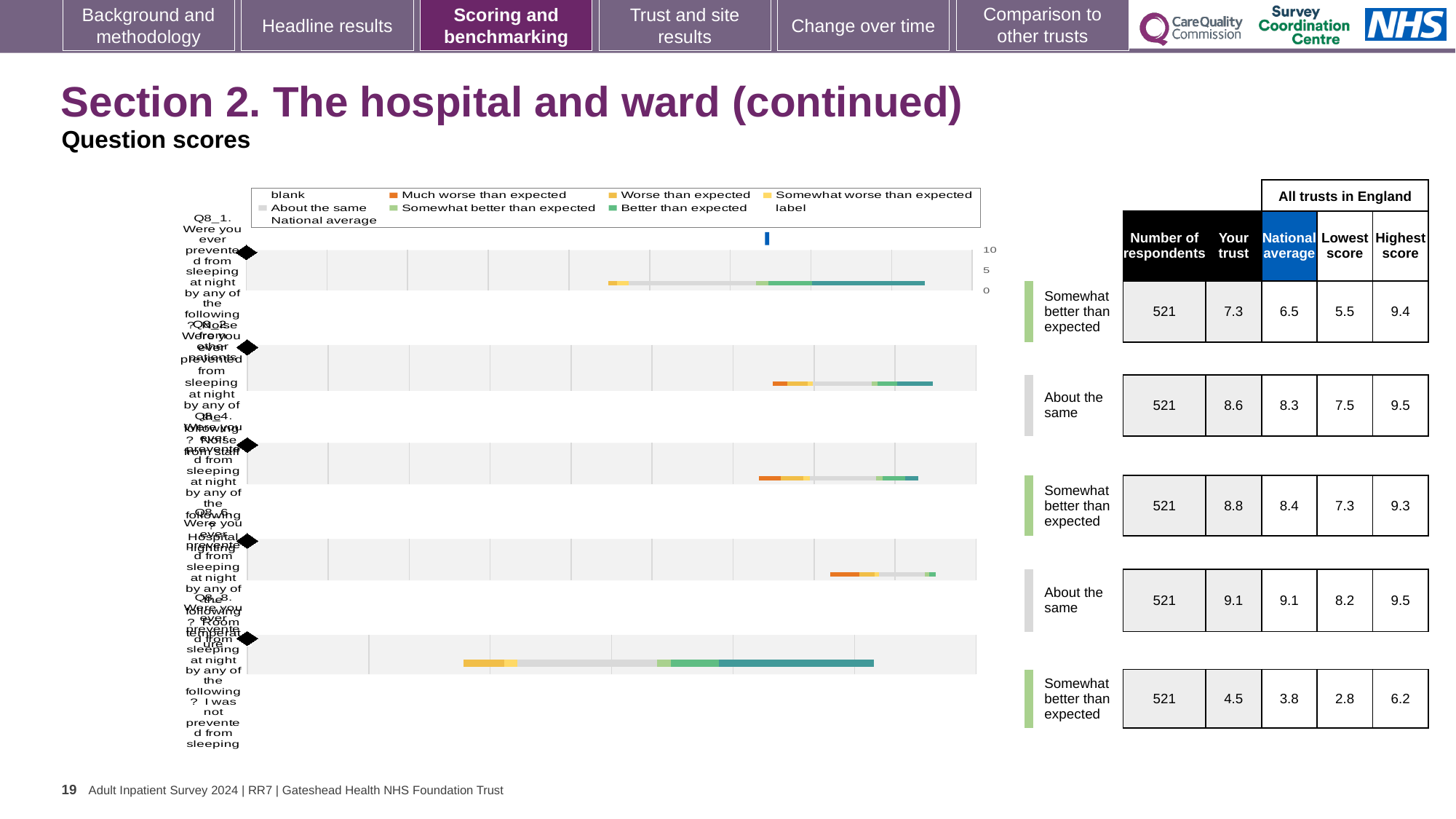
How many question rows (bars) does the chart show? 5 What is the highest value shown on the chart's axis? 10 How many entries does the chart legend list? 9 Which legend entry is shown in orange-red? Much worse than expected What is the difference between the highest and lowest 'Your trust' scores? 4.6 For Q8_4 (hospital lighting), is the 'Your trust' score or the national average higher? Your trust Which question has the highest 'Your trust' score? Q8_6 (Room temperature) What kind of chart is shown on the slide? bar chart What is the 'Your trust' score for Q8_1 (noise from other patients)? 7.3 How many respondents are listed for Q8_2 (noise from staff)? 521 What is the national average score for Q8_8 (I was not prevented from sleeping)? 3.8 Which question has the lowest 'Your trust' score? Q8_8 (I was not prevented from sleeping)